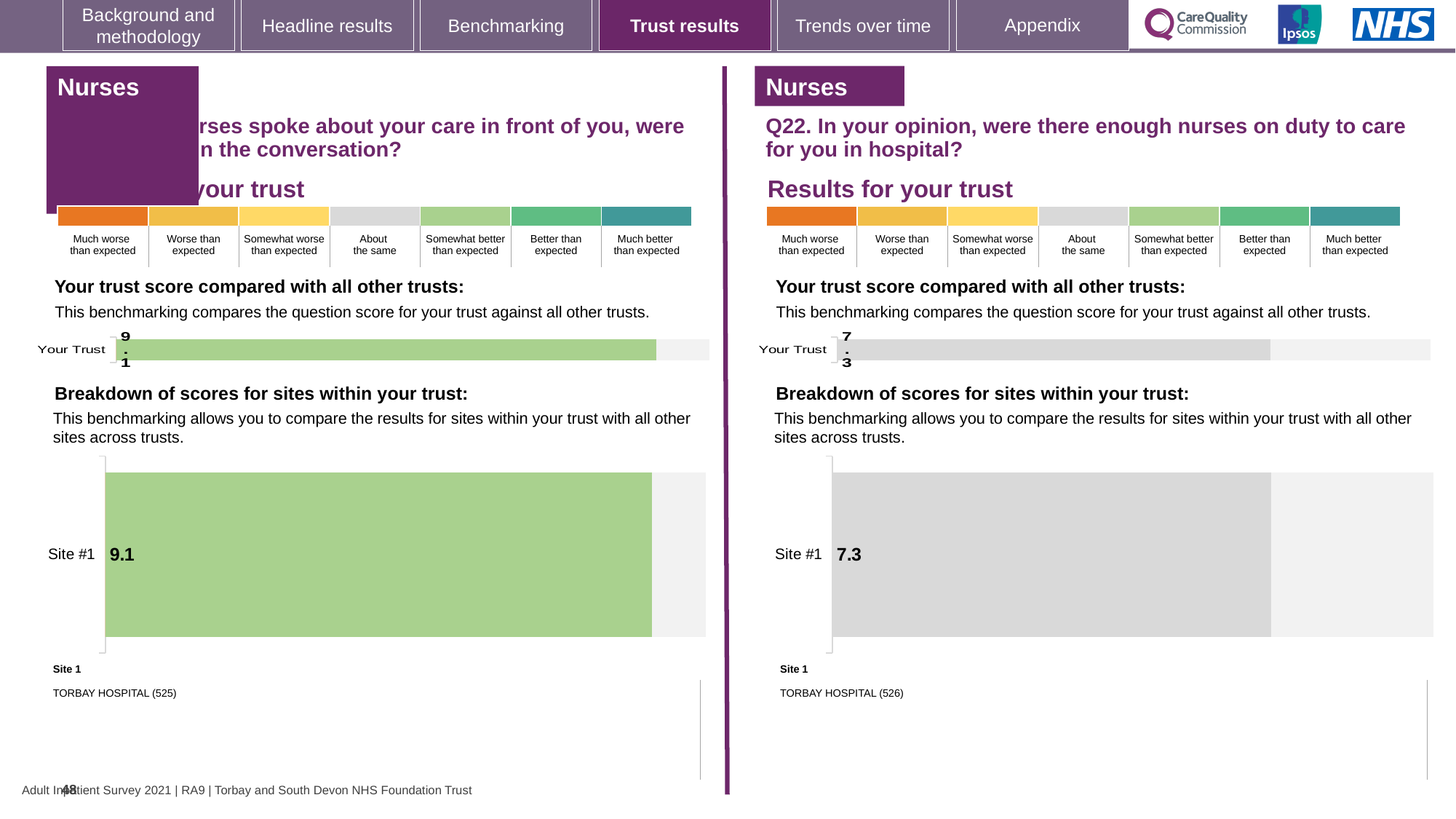
What colour is the Site #1 bar in the breakdown chart on the right-hand side of the slide (Q22)? Grey On the right-hand side of the slide (Q22), what is the score shown for Your Trust? 7.3 Which is larger: the Site #1 score on the left-hand side of the slide or the Site #1 score on the right-hand side (Q22)? Left-hand side (9.1) On the left-hand side of the slide, what is the score shown for Your Trust? 9.1 In the 'Breakdown of scores for sites within your trust' chart on the left-hand side, what is the score for Site #1? 9.1 What type of chart is used to show the Site #1 score on the left-hand side of the slide? Bar chart Which site name is listed as Site 1 on the right-hand side of the slide (Q22)? TORBAY HOSPITAL (526) In the 'Breakdown of scores for sites within your trust' chart on the right-hand side (Q22), what is the score for Site #1? 7.3 What is the difference between the Site #1 score on the left-hand side of the slide and the Site #1 score on the right-hand side (Q22)? 1.8 How many sites are shown in the 'Breakdown of scores for sites within your trust' chart on the right-hand side (Q22)? 1